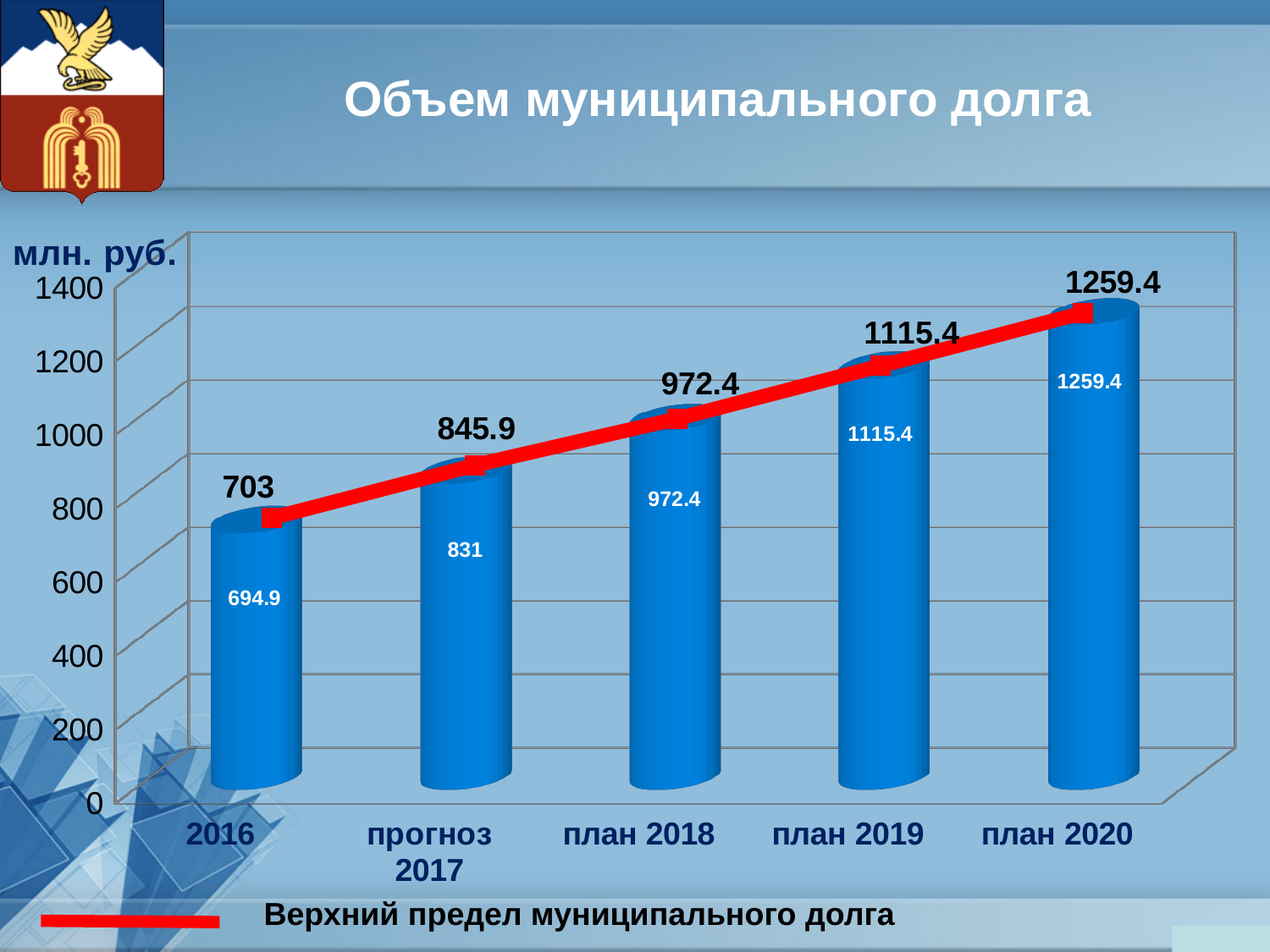
Which category has the lowest bar value? 2016 Which category has the highest bar value? план 2020 What is the upper limit of municipal debt (Верхний предел муниципального долга) shown for 2016? 703 What is the upper limit of municipal debt (Верхний предел муниципального долга) shown for прогноз 2017? 845.9 What is the value of the bar for план 2020? 1259.4 Do the bar values rise or fall from 2016 to план 2020? rise What is the value of the bar for 2016? 694.9 What is the title of the chart? Объем муниципального долга What is the difference between the bar values for план 2020 and план 2019? 144 How many categories are shown on the x axis? 5 What is the difference between the upper limit of municipal debt and the bar value for 2016? 8.1 What is the value of the bar for прогноз 2017? 831